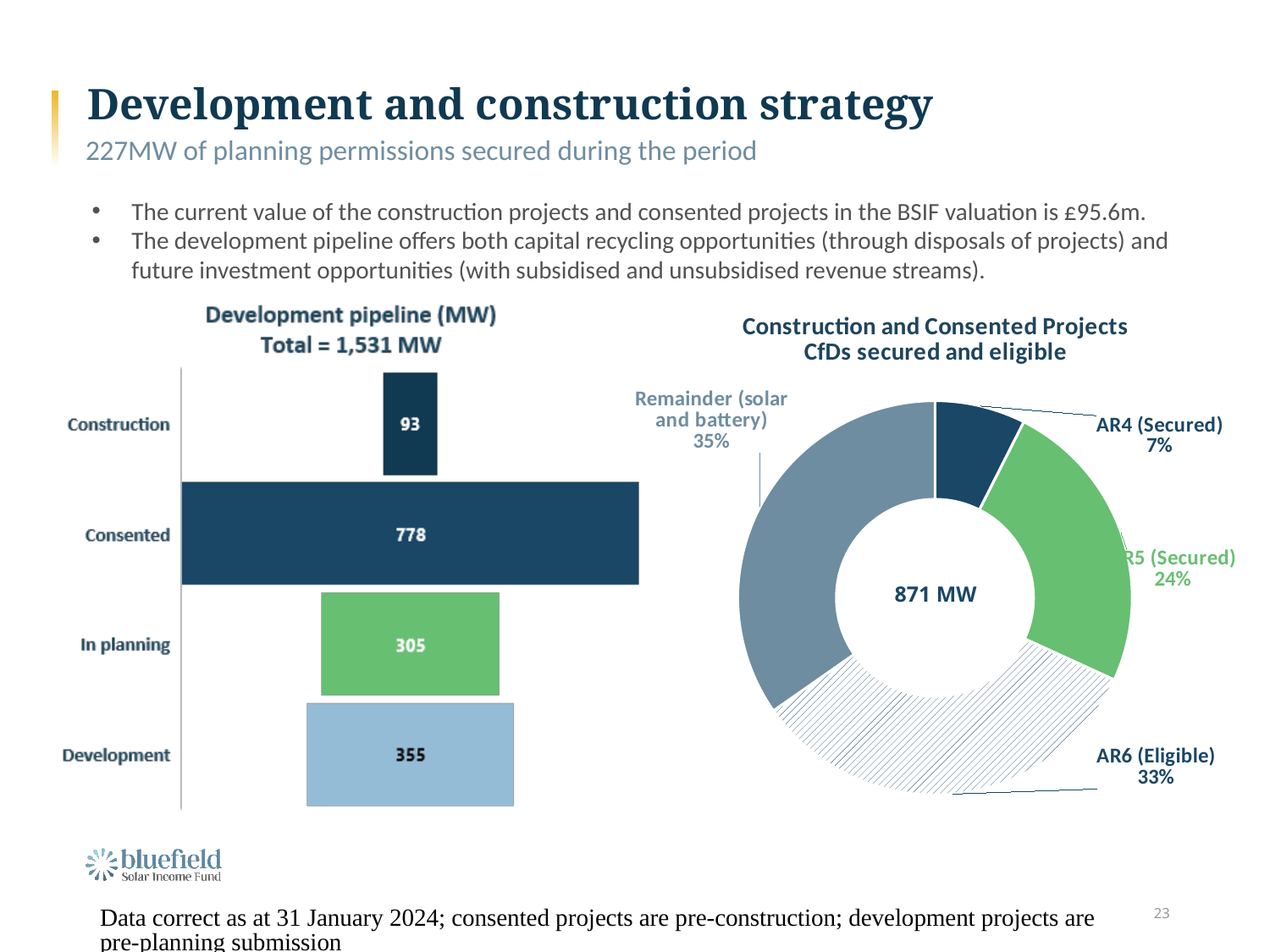
In the Development pipeline (MW) chart, what is the value for Consented? 778 In the Development pipeline (MW) chart, what is the difference between Development and In planning? 50 In the Development pipeline (MW) chart, what is the value for Development? 355 In the Development pipeline (MW) chart, which category has the lowest value? Construction What total is stated in the title of the Development pipeline (MW) chart? 1,531 MW In the Construction and Consented Projects CfDs secured and eligible chart, what share is AR6 (Eligible)? 33% In the Development pipeline (MW) chart, which is larger, In planning or Development? Development What kind of chart is the Construction and Consented Projects CfDs secured and eligible chart? Donut chart How many categories are shown in the Development pipeline (MW) chart? 4 In the Construction and Consented Projects CfDs secured and eligible chart, what share is Remainder (solar and battery)? 35% In the Development pipeline (MW) chart, what is the value for Construction? 93 In the Development pipeline (MW) chart, which category has the highest value? Consented